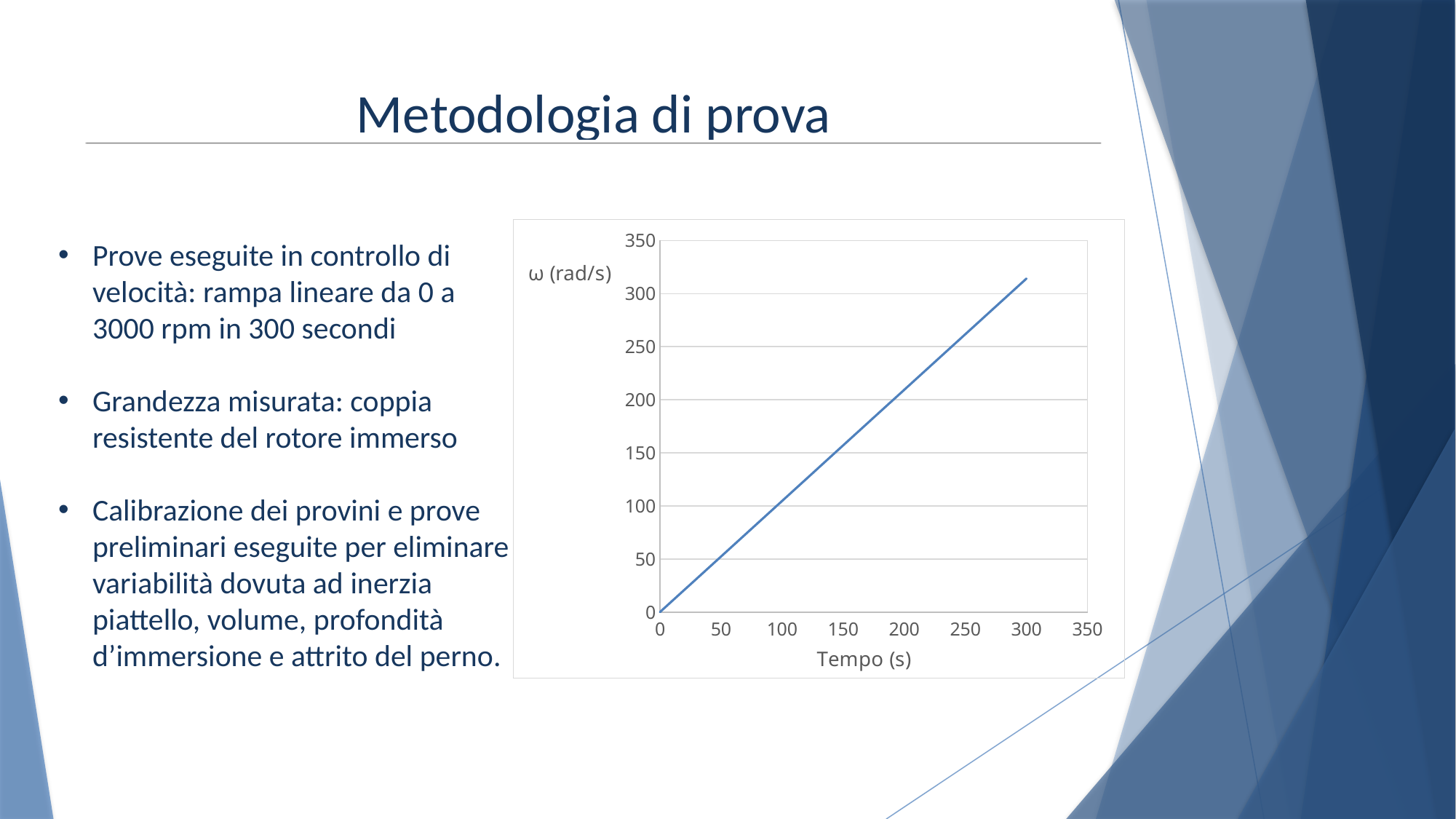
What is the value of ω (rad/s) at Tempo 0 s? 0 Is the value of ω at Tempo 150 s greater or less than 100? greater Is the value of ω at Tempo 250 s greater or less than 200? greater Is the value of ω at Tempo 50 s greater or less than 100? less At which Tempo value does the plotted line reach its highest ω? 300 How many lines are plotted on the chart? 1 What kind of chart is shown on the slide? line chart Does the plotted line rise or fall as Tempo (s) increases? rises What quantity is plotted on the vertical axis of the chart? ω (rad/s) What is the label of the horizontal axis of the chart? Tempo (s)